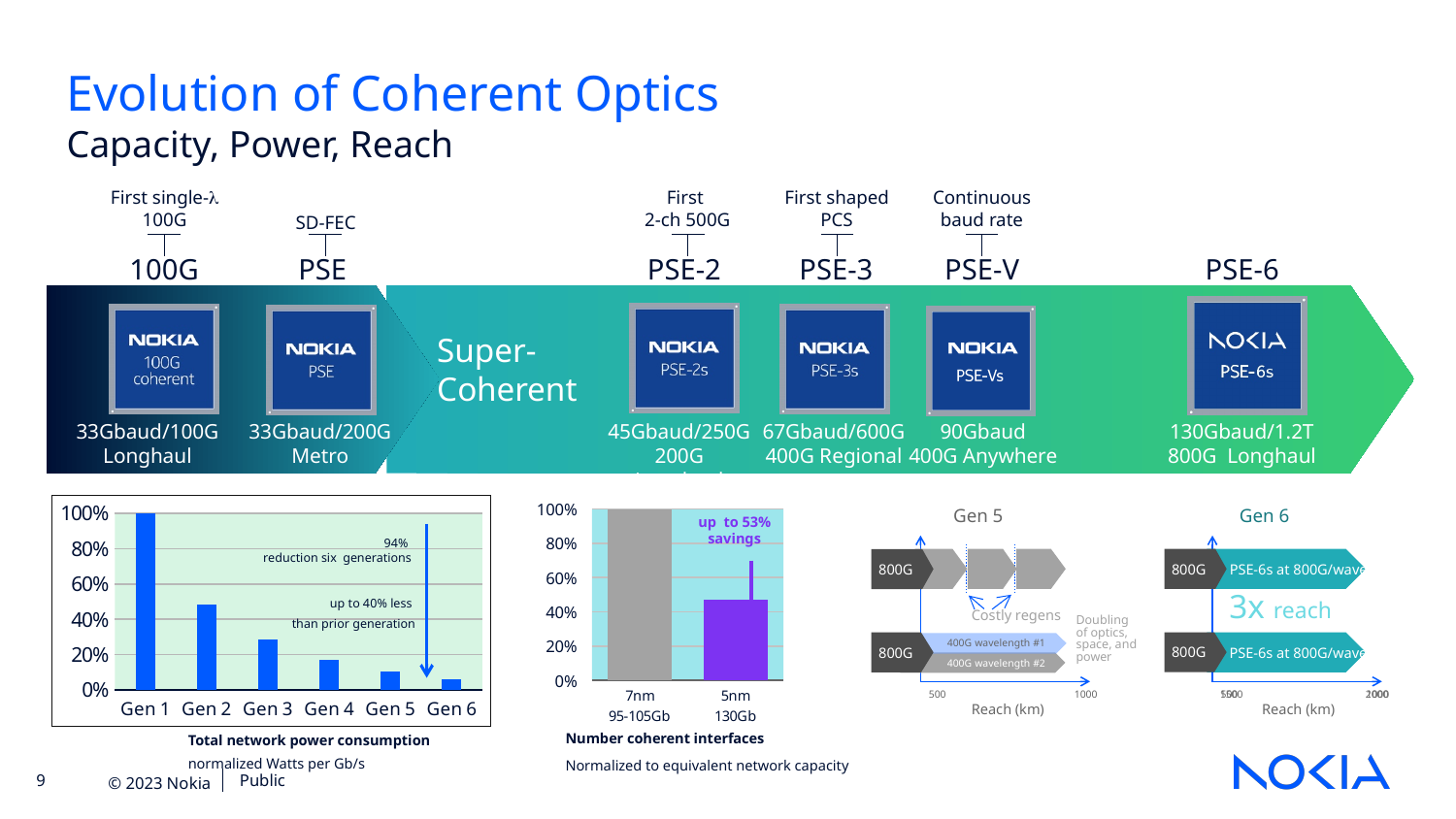
In the 'Total network power consumption' chart, how many generations are plotted? 6 In the 'Number coherent interfaces' chart, how many categories are shown on the x axis? 2 In the 'Total network power consumption' chart, is the value for Gen 2 greater or less than 60%? less In the 'Number coherent interfaces' chart, is the value for 5nm greater or less than 60%? less In the 'Total network power consumption' chart, which is larger, Gen 4 or Gen 5? Gen 4 In the 'Total network power consumption' chart, which generation has the lowest value? Gen 6 In the 'Number coherent interfaces' chart, what savings does the annotation above the 5nm bar state? up to 53% savings In the 'Total network power consumption' chart, what is the value for Gen 1? 100% What kind of chart is the 'Total network power consumption' chart? bar chart In the 'Total network power consumption' chart, which generation has the highest value? Gen 1 In the 'Total network power consumption' chart, do the values rise or fall from Gen 1 to Gen 6? fall In the 'Total network power consumption' chart, is the value for Gen 3 greater or less than 40%? less